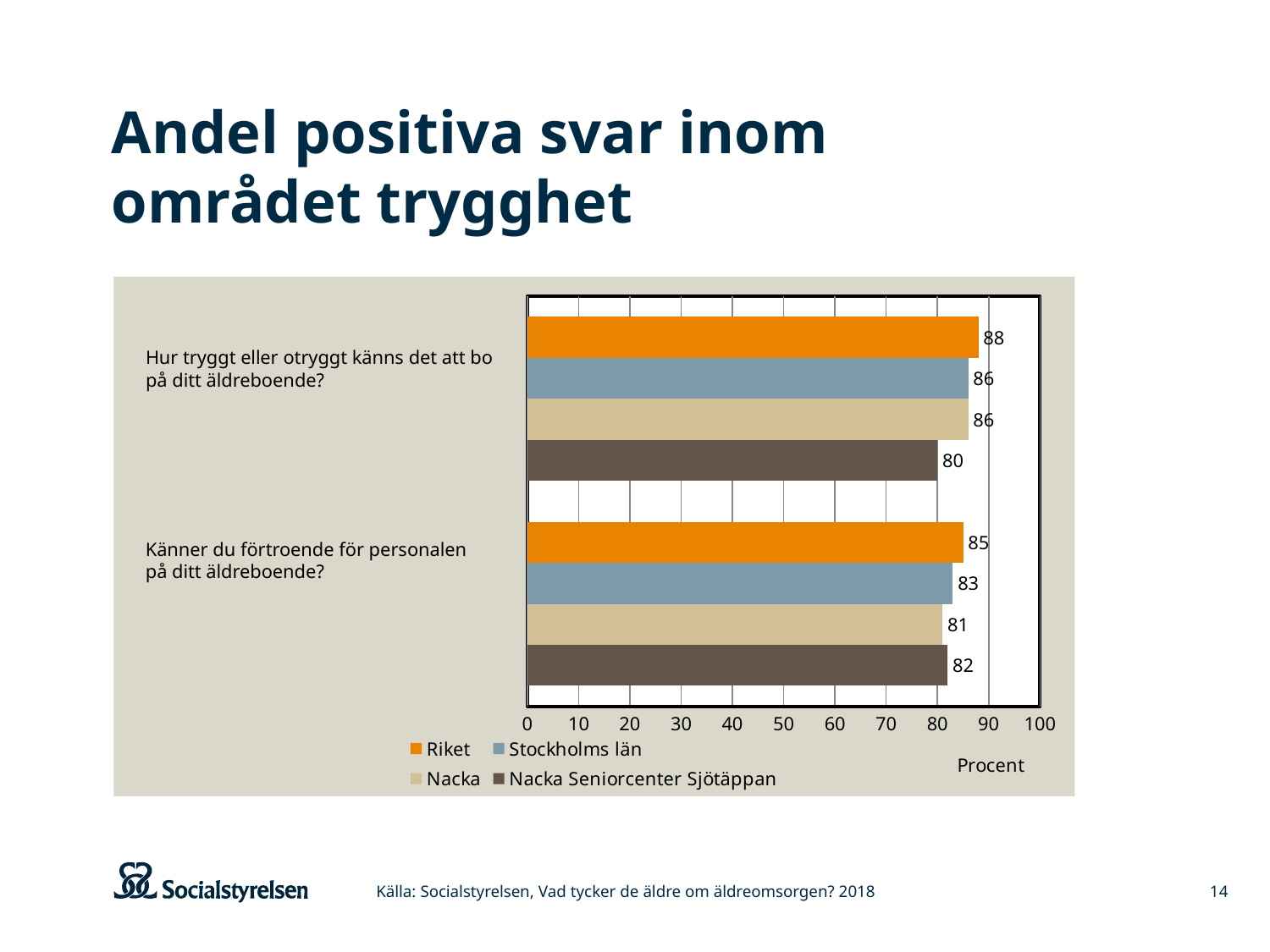
What is the difference between Riket and Nacka Seniorcenter Sjötäppan on the question "Hur tryggt eller otryggt känns det att bo på ditt äldreboende?"? 8 What is the value for Nacka on the question "Känner du förtroende för personalen på ditt äldreboende?"? 81 What is the value for Riket on the question "Hur tryggt eller otryggt känns det att bo på ditt äldreboende?"? 88 Which series has the lowest value on the question "Känner du förtroende för personalen på ditt äldreboende?"? Nacka Which series has the highest value on the question "Hur tryggt eller otryggt känns det att bo på ditt äldreboende?"? Riket Which is larger on the question "Känner du förtroende för personalen på ditt äldreboende?": Riket or Nacka Seniorcenter Sjötäppan? Riket How many questions (categories) are shown on the chart? 2 What is the value for Stockholms län on the question "Känner du förtroende för personalen på ditt äldreboende?"? 83 What kind of chart is shown on the slide? Bar chart How many series does the legend list? 4 What unit is shown on the x axis of the chart? Procent What is the value for Nacka Seniorcenter Sjötäppan on the question "Hur tryggt eller otryggt känns det att bo på ditt äldreboende?"? 80